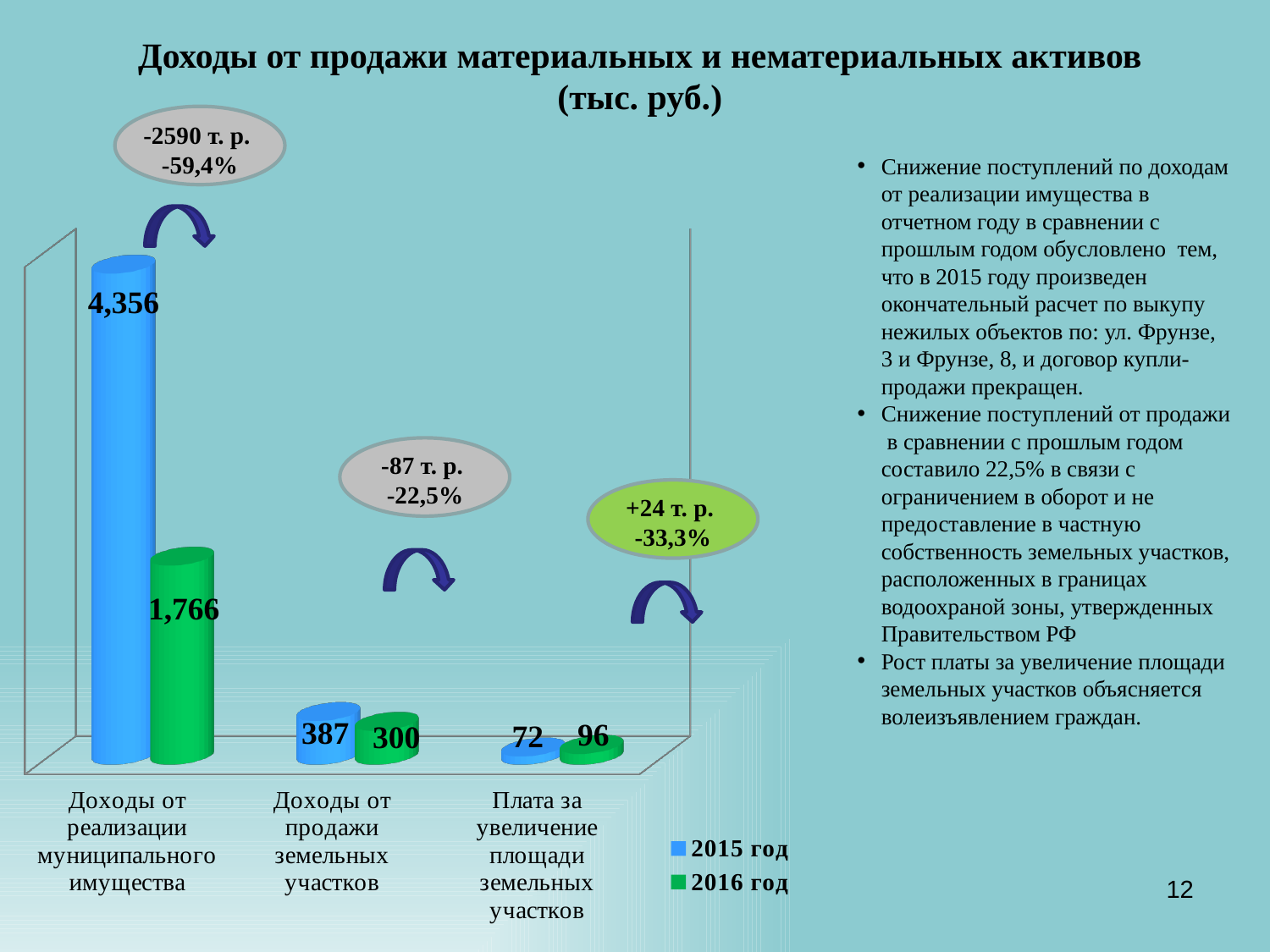
What is the value for 2015 год for Доходы от реализации муниципального имущества? 4,356 How many series does the legend list? 2 How many categories are shown on the x axis of the chart? 3 What is the title of the chart? Доходы от продажи материальных и нематериальных активов (тыс. руб.) What is the value for 2016 год for Доходы от реализации муниципального имущества? 1,766 What is the value for 2015 год for Доходы от продажи земельных участков? 387 What kind of chart is shown on the slide? Bar chart Which category has the highest value for 2015 год? Доходы от реализации муниципального имущества For Плата за увеличение площади земельных участков, which is larger: the 2015 год value or the 2016 год value? 2016 год What is the value for 2016 год for Плата за увеличение площади земельных участков? 96 What is the difference between the 2015 год and 2016 год values for Доходы от продажи земельных участков? 87 Which category has the lowest value for 2016 год? Плата за увеличение площади земельных участков